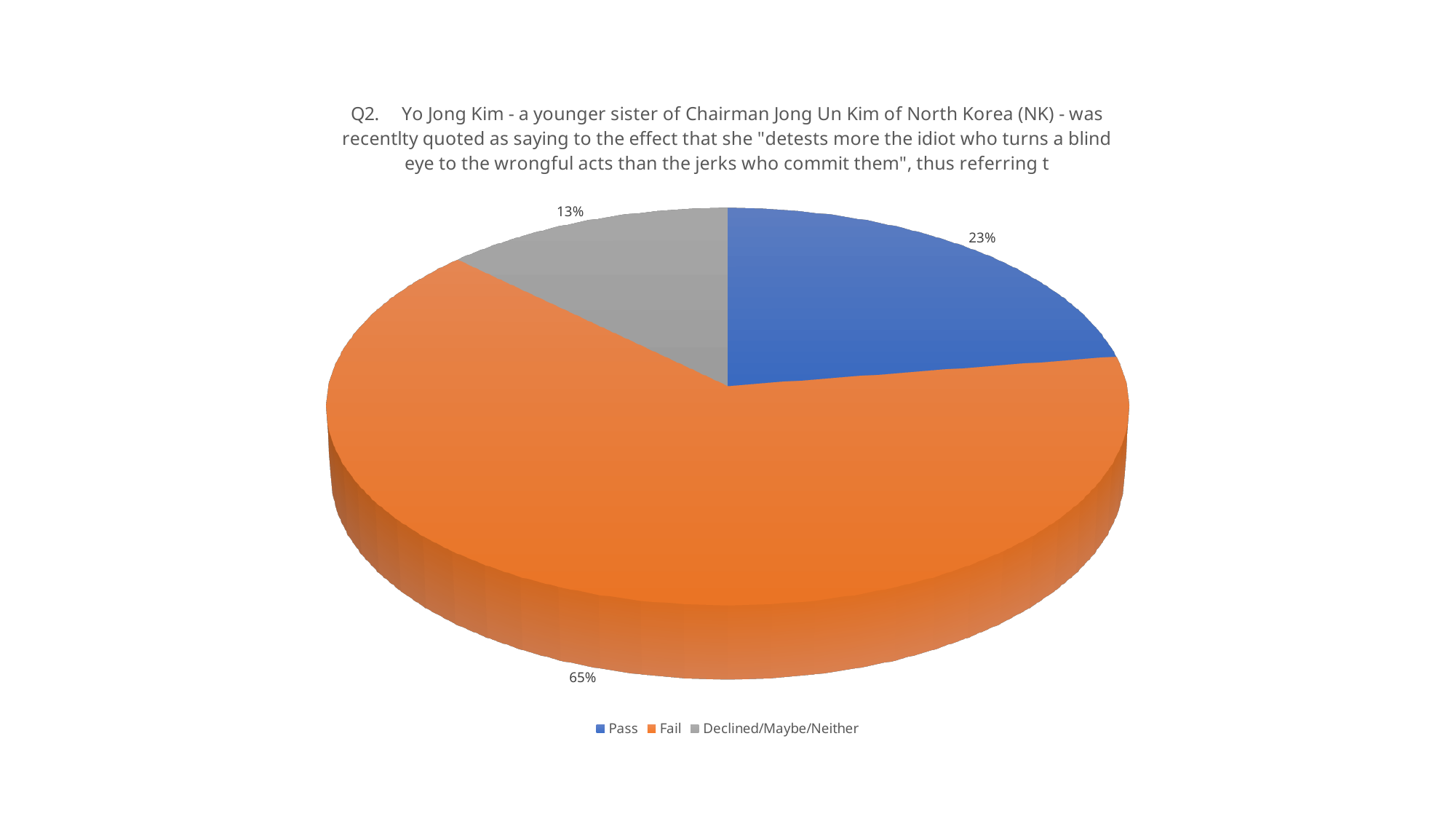
What percentage of the pie is labelled Fail? 65% What percentage of the pie is labelled Declined/Maybe/Neither? 13% How many entries does the legend list? 3 Which category has the smallest share of the pie? Declined/Maybe/Neither What percentage of the pie is labelled Pass? 23% What is the difference in percentage points between the Fail and Pass slices? 42 What kind of chart is shown on the slide? Pie chart Which is larger, the Pass slice or the Declined/Maybe/Neither slice? Pass What colour is the Fail slice? Orange Which category has the largest share of the pie? Fail How many slices does the pie chart have? 3 What is the difference in percentage points between the Pass and Declined/Maybe/Neither slices? 10